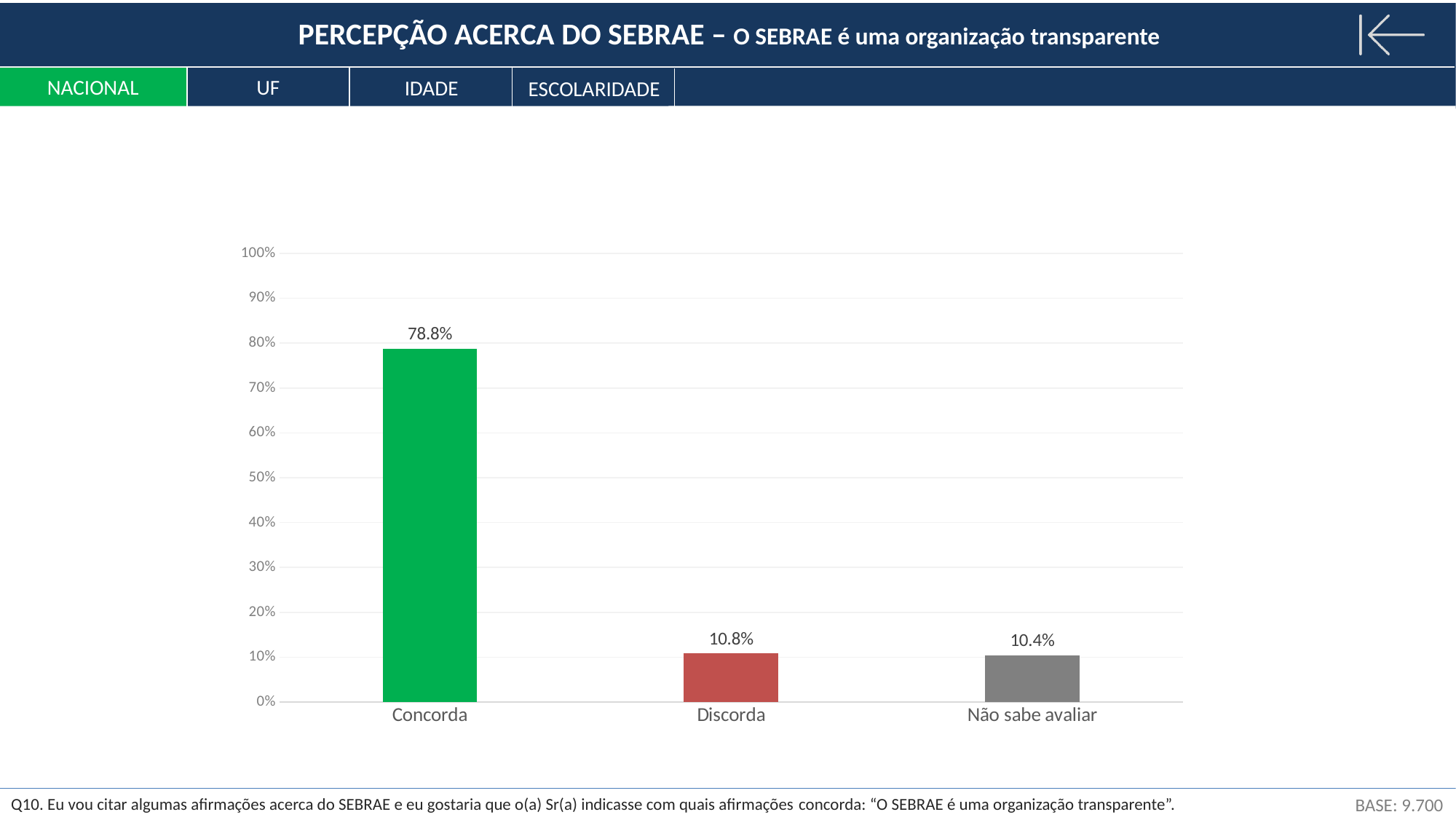
What is the difference between the values for Discorda and Não sabe avaliar? 0.4% What is the value for Não sabe avaliar? 10.4% What colour is the bar for Concorda? green What is the value for Concorda? 78.8% Which category has the highest value? Concorda How many categories are shown on the x axis? 3 Is the value for Concorda greater or less than 70%? greater What is the difference between the values for Concorda and Discorda? 68.0% What is the value for Discorda? 10.8% What kind of chart is shown on the slide? bar chart Is the value for Não sabe avaliar greater or less than 20%? less What is the base (sample size) shown on the slide? 9.700